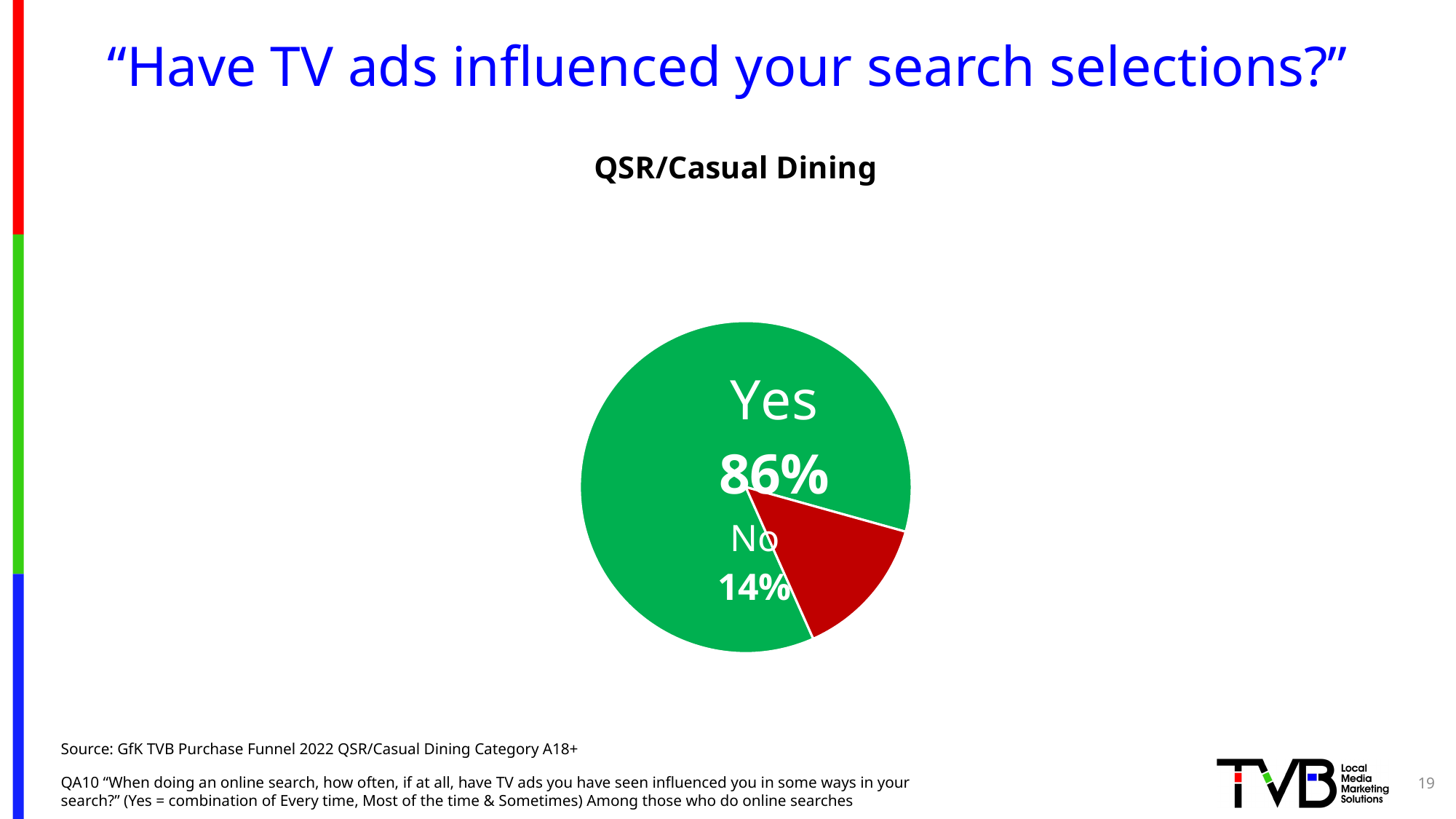
What colour is the Yes slice of the pie chart? Green Which response has the smallest share of the pie chart? No Which slice is larger, Yes or No? Yes Which response has the largest share of the pie chart? Yes How many slices does the pie chart have? 2 What kind of chart is shown on the slide? Pie chart What share of the pie does the No slice represent? 14% What percentage of respondents answered No in the QSR/Casual Dining pie chart? 14% What is the difference in percentage points between the Yes and No slices? 72 What percentage of respondents answered Yes in the QSR/Casual Dining pie chart? 86% What is the title of the chart? QSR/Casual Dining